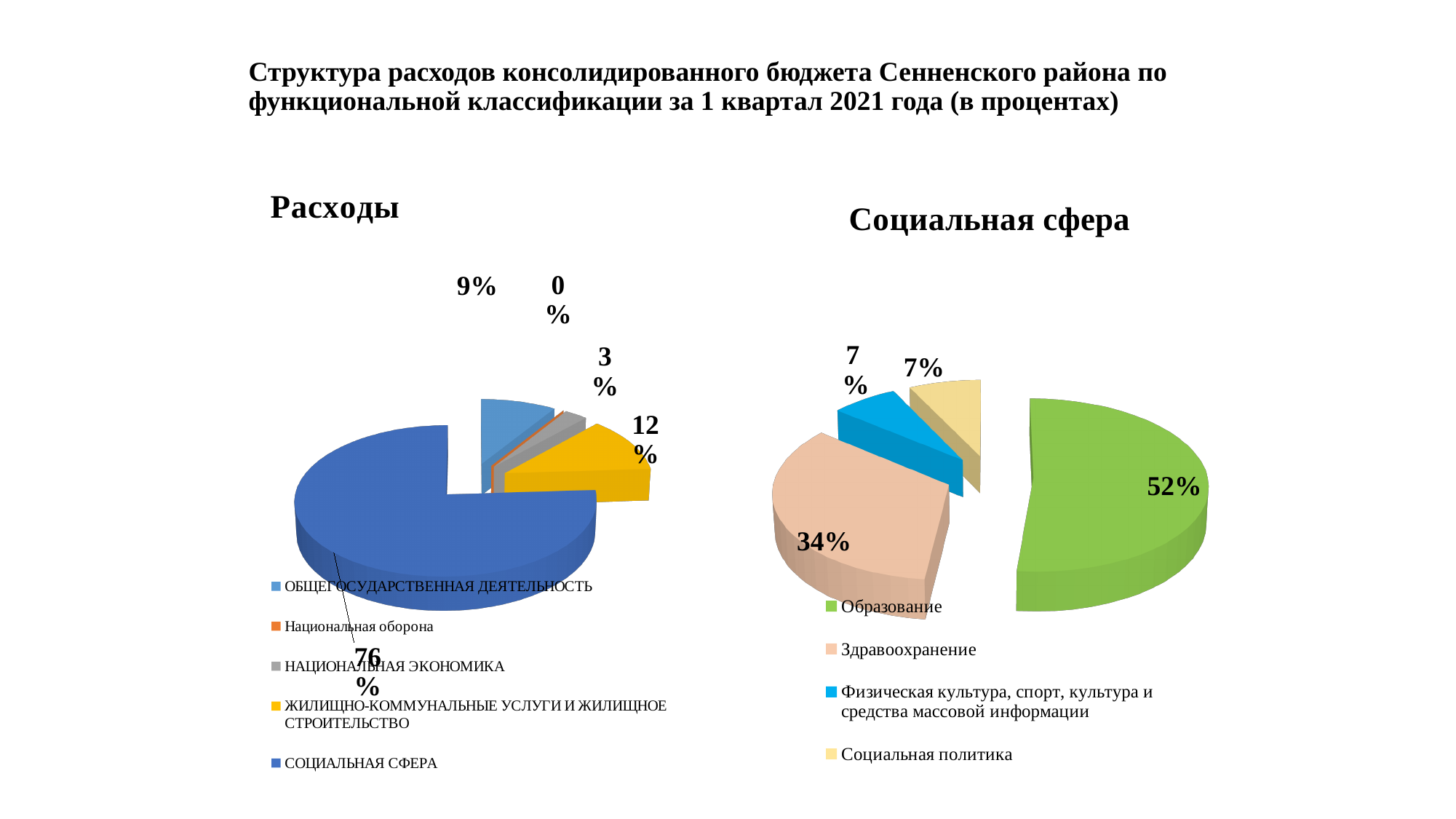
In the "Расходы" chart, how many categories does the legend list? 5 In the "Расходы" chart, which category has the largest share? СОЦИАЛЬНАЯ СФЕРА In the "Социальная сфера" chart, which is larger: Образование or Здравоохранение? Образование In the "Социальная сфера" chart, what share is labelled for Образование? 52% In the "Социальная сфера" chart, what share is labelled for Здравоохранение? 34% In the "Расходы" chart, what share is labelled for ОБЩЕГОСУДАРСТВЕННАЯ ДЕЯТЕЛЬНОСТЬ? 9% In the "Расходы" chart, what is the difference between the shares of СОЦИАЛЬНАЯ СФЕРА and ЖИЛИЩНО-КОММУНАЛЬНЫЕ УСЛУГИ И ЖИЛИЩНОЕ СТРОИТЕЛЬСТВО? 64 percentage points In the "Расходы" chart, what share is labelled for СОЦИАЛЬНАЯ СФЕРА? 76% In the "Расходы" chart, what share is labelled for Национальная оборона? 0% What type of chart is the "Социальная сфера" chart? Pie chart In the "Расходы" chart, what share is labelled for ЖИЛИЩНО-КОММУНАЛЬНЫЕ УСЛУГИ И ЖИЛИЩНОЕ СТРОИТЕЛЬСТВО? 12% In the "Социальная сфера" chart, what share is labelled for Социальная политика? 7%